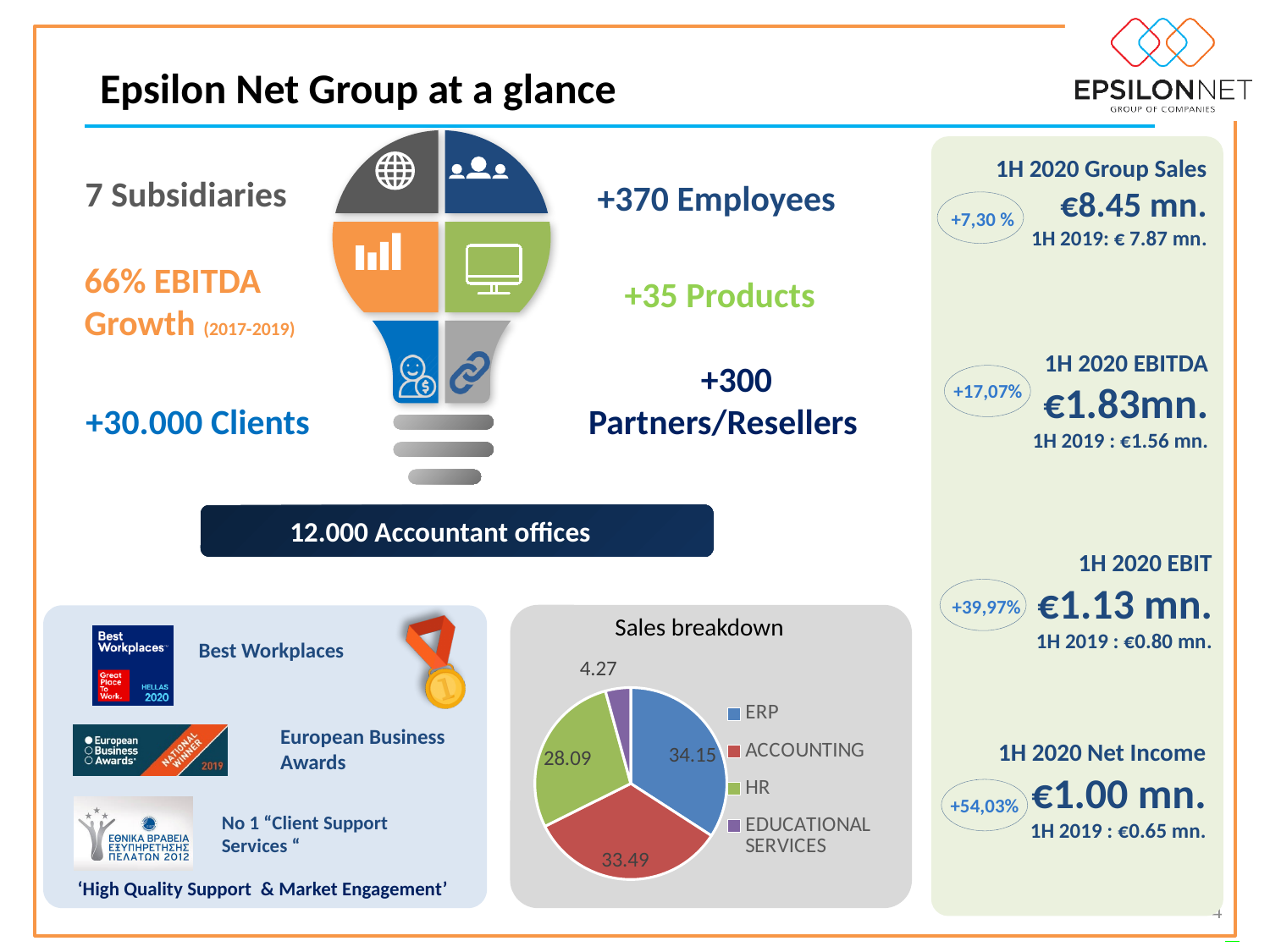
How many categories does the Sales breakdown chart show? 4 Which category has the largest slice in the Sales breakdown chart? ERP In the Sales breakdown chart, what is the difference between the ERP and ACCOUNTING values? 0.66 What type of chart is the Sales breakdown chart? pie chart In the Sales breakdown chart, which is larger: HR or EDUCATIONAL SERVICES? HR What colour is the ACCOUNTING slice in the Sales breakdown chart? red In the Sales breakdown chart, what is the value for ACCOUNTING? 33.49 In the Sales breakdown chart, what is the value for ERP? 34.15 Which category has the smallest slice in the Sales breakdown chart? EDUCATIONAL SERVICES In the Sales breakdown chart, what is the difference between the HR and EDUCATIONAL SERVICES values? 23.82 In the Sales breakdown chart, what is the value for EDUCATIONAL SERVICES? 4.27 In the Sales breakdown chart, what is the value for HR? 28.09